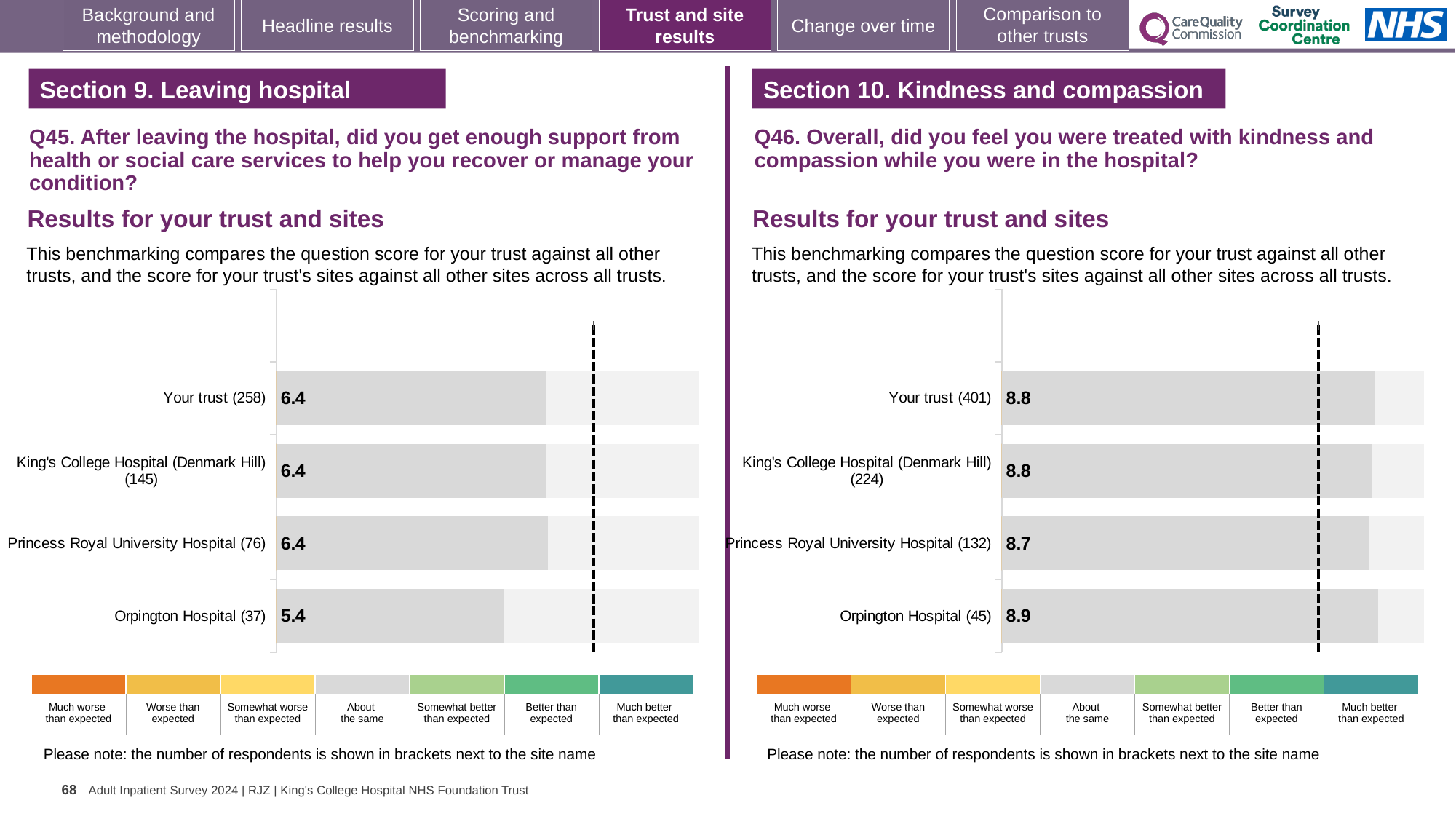
In the Q46 chart on the right, how many respondents are shown for King's College Hospital (Denmark Hill)? 224 What kind of chart is used for the Q45 results on the left? Bar chart In the Q45 chart on the left, what is the score for Your trust (258)? 6.4 In the Q46 chart on the right, what is the difference between the score for Orpington Hospital (45) and Princess Royal University Hospital (132)? 0.2 In the Q46 chart on the right, what is the score for Orpington Hospital (45)? 8.9 In the Q45 chart on the left, what is the difference between the score for Your trust (258) and Orpington Hospital (37)? 1.0 In the Q45 chart on the left, how many bars are plotted? 4 In the Q45 chart on the left, which site has the lowest score? Orpington Hospital (37) In the Q46 chart on the right, which is larger: the score for Your trust (401) or Princess Royal University Hospital (132)? Your trust (401) In the Q46 chart on the right, what is the score for Princess Royal University Hospital (132)? 8.7 In the Q46 chart on the right, which site has the highest score? Orpington Hospital (45) In the Q45 chart on the left, what is the score for Orpington Hospital (37)? 5.4